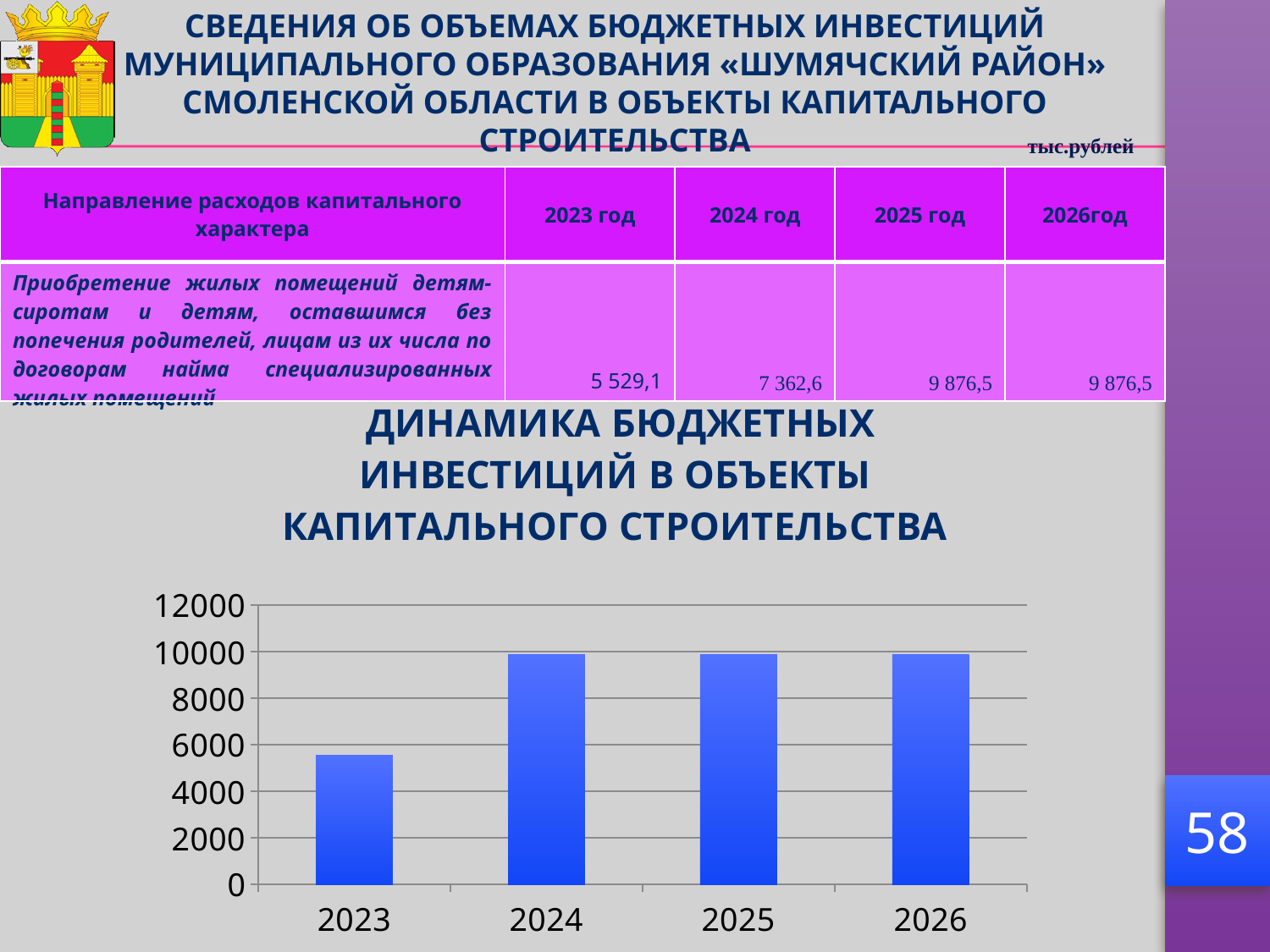
Is the value for 2026 greater or less than 12000? less Is the value for 2024 greater or less than 8000? greater Do the values rise or fall from 2023 to 2024? rise What is the title of the chart? ДИНАМИКА БЮДЖЕТНЫХ ИНВЕСТИЦИЙ В ОБЪЕКТЫ КАПИТАЛЬНОГО СТРОИТЕЛЬСТВА Which is larger, the value for 2023 or the value for 2025? 2025 What kind of chart is shown on the slide? bar chart Is the value for 2025 greater or less than 8000? greater How many years (categories) are plotted on the x axis of the chart? 4 What is the highest value shown on the chart's vertical axis? 12000 Which year has the lowest bar in the chart? 2023